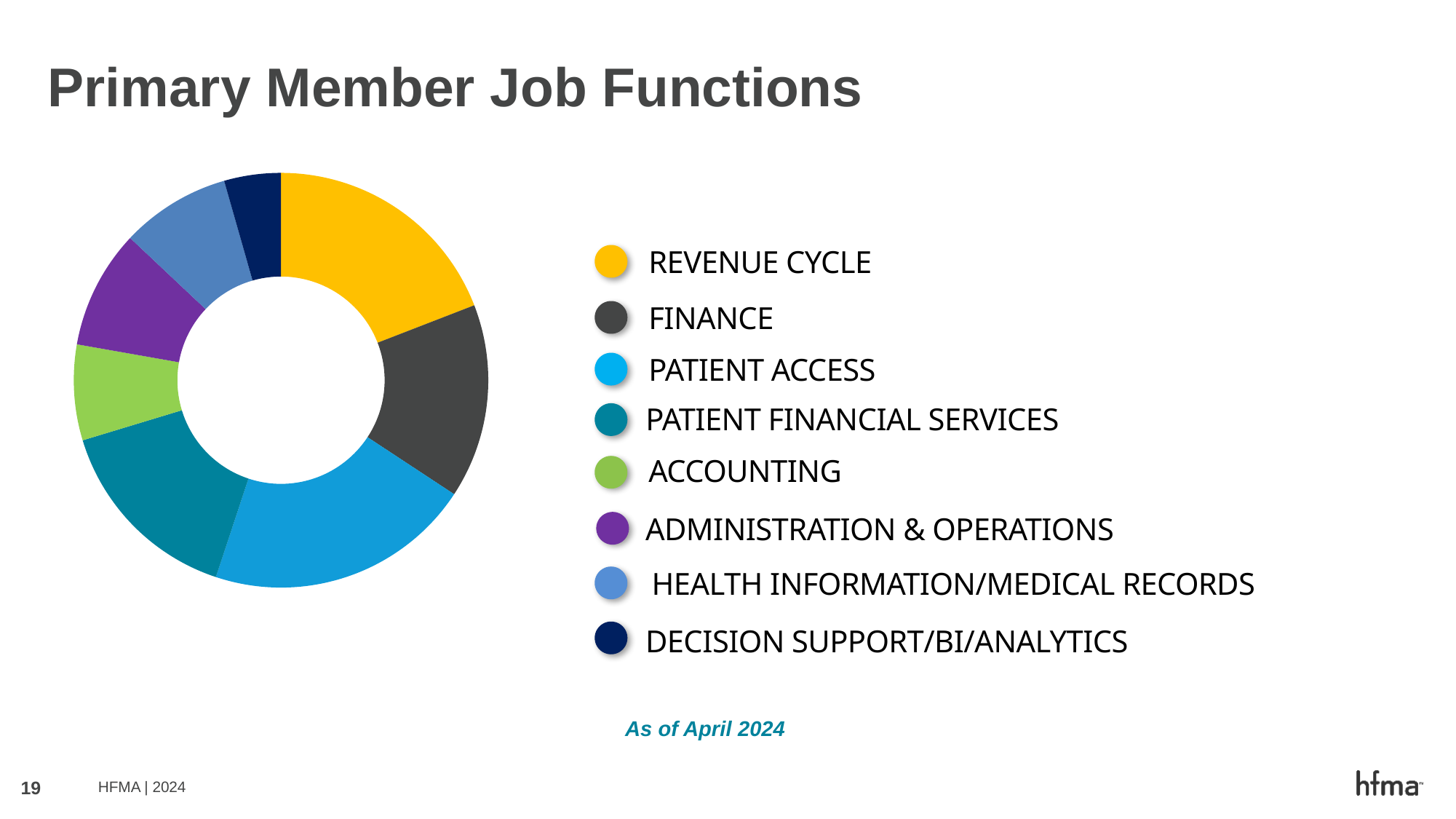
Which slice is larger, Patient Access or Health Information/Medical Records? Patient Access Which slice is larger, Revenue Cycle or Finance? Revenue Cycle What kind of chart is shown on the slide? Pie chart (donut) What is the title of the chart on the slide? Primary Member Job Functions Which job function has the smallest slice of the chart? Decision Support/BI/Analytics Which job function is shown in yellow on the chart? Revenue Cycle How many job function categories does the chart show? 8 Which slice is larger, Finance or Administration & Operations? Finance